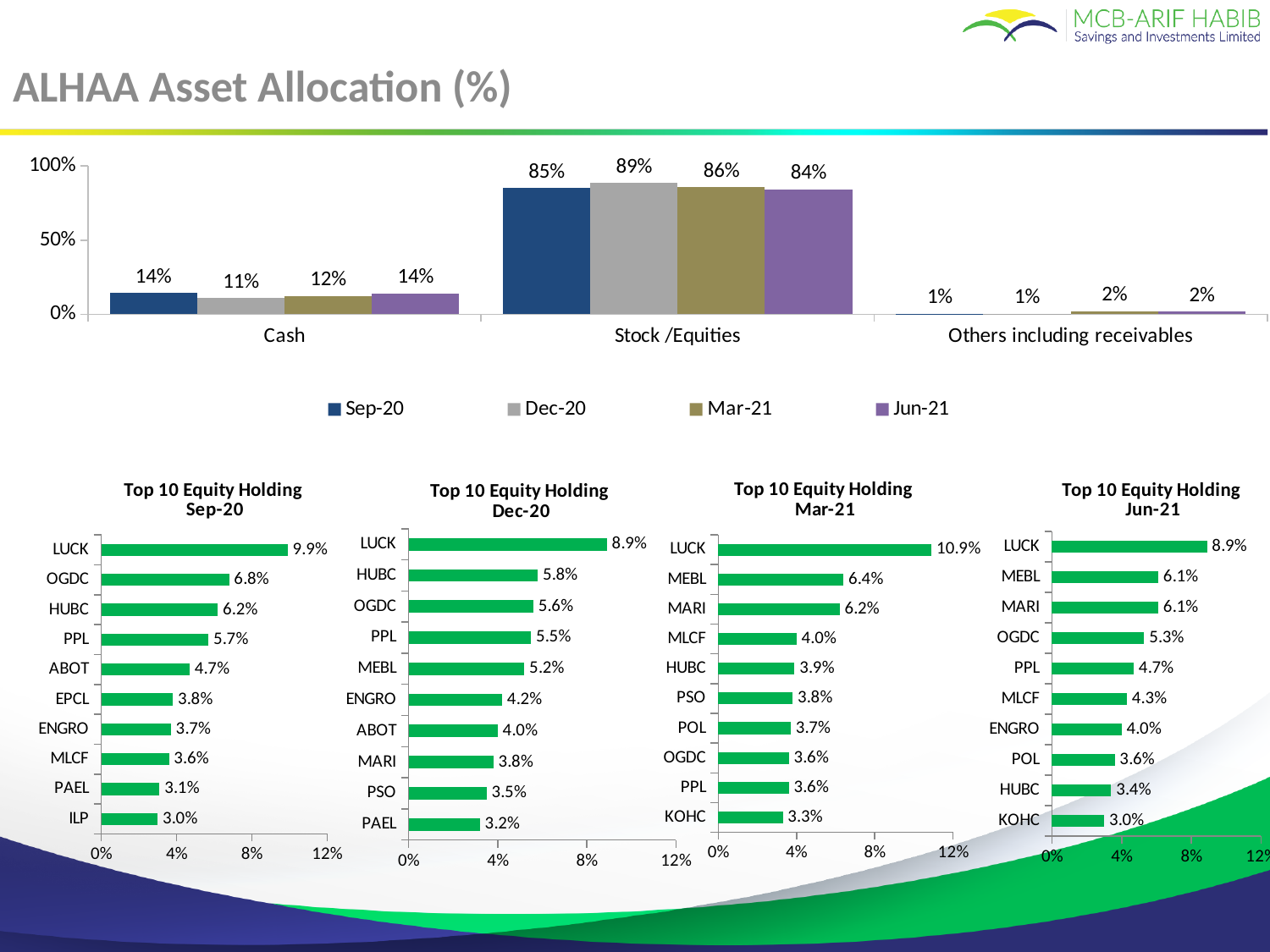
In the Top 10 Equity Holding Mar-21 chart, which holding has the highest value? LUCK In the Top 10 Equity Holding Jun-21 chart, which is larger, the value for OGDC or the value for PPL? OGDC In the Top 10 Equity Holding Mar-21 chart, what is the value for LUCK? 10.9% In the top asset allocation chart, what is the value for Cash in Sep-20? 14% In the top asset allocation chart, which category has the lowest values across all periods? Others including receivables In the top asset allocation chart, how many series does the legend list? 4 In the top asset allocation chart, what is the value for Stock /Equities in Dec-20? 89% In the top asset allocation chart, what is the difference between the Stock /Equities values for Dec-20 and Jun-21? 5% What kind of chart is the Top 10 Equity Holding Sep-20 chart? Bar chart In the Top 10 Equity Holding Jun-21 chart, what is the difference between the values for LUCK and KOHC? 5.9% In the Top 10 Equity Holding Sep-20 chart, what is the value for OGDC? 6.8% In the Top 10 Equity Holding Dec-20 chart, which holding has the lowest value? PAEL